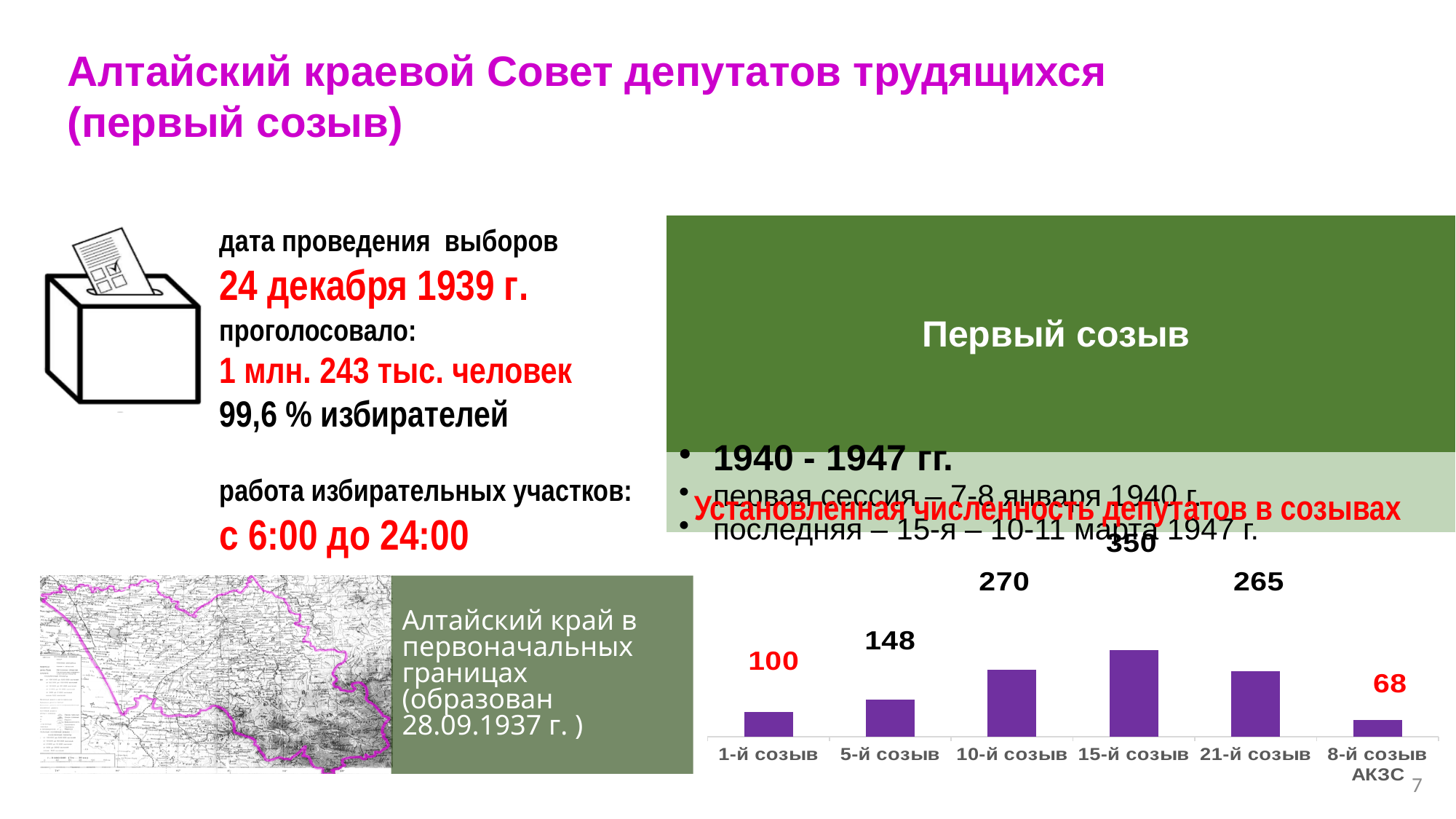
Which category has the highest value in the chart? 15-й созыв What is the value for 8-й созыв АКЗС in the chart? 68 What is the difference between the values for 15-й созыв and 21-й созыв? 85 What kind of chart is shown on the slide? Bar chart How many categories are shown in the chart? 6 Which is larger, the value for 10-й созыв or the value for 21-й созыв? 10-й созыв What is the title of the chart on the slide? Установленная численность депутатов в созывах What is the value for 1-й созыв in the chart? 100 What is the value for 10-й созыв in the chart? 270 What is the difference between the values for 10-й созыв and 5-й созыв? 122 What is the value for 5-й созыв in the chart? 148 Which category has the lowest value in the chart? 8-й созыв АКЗС